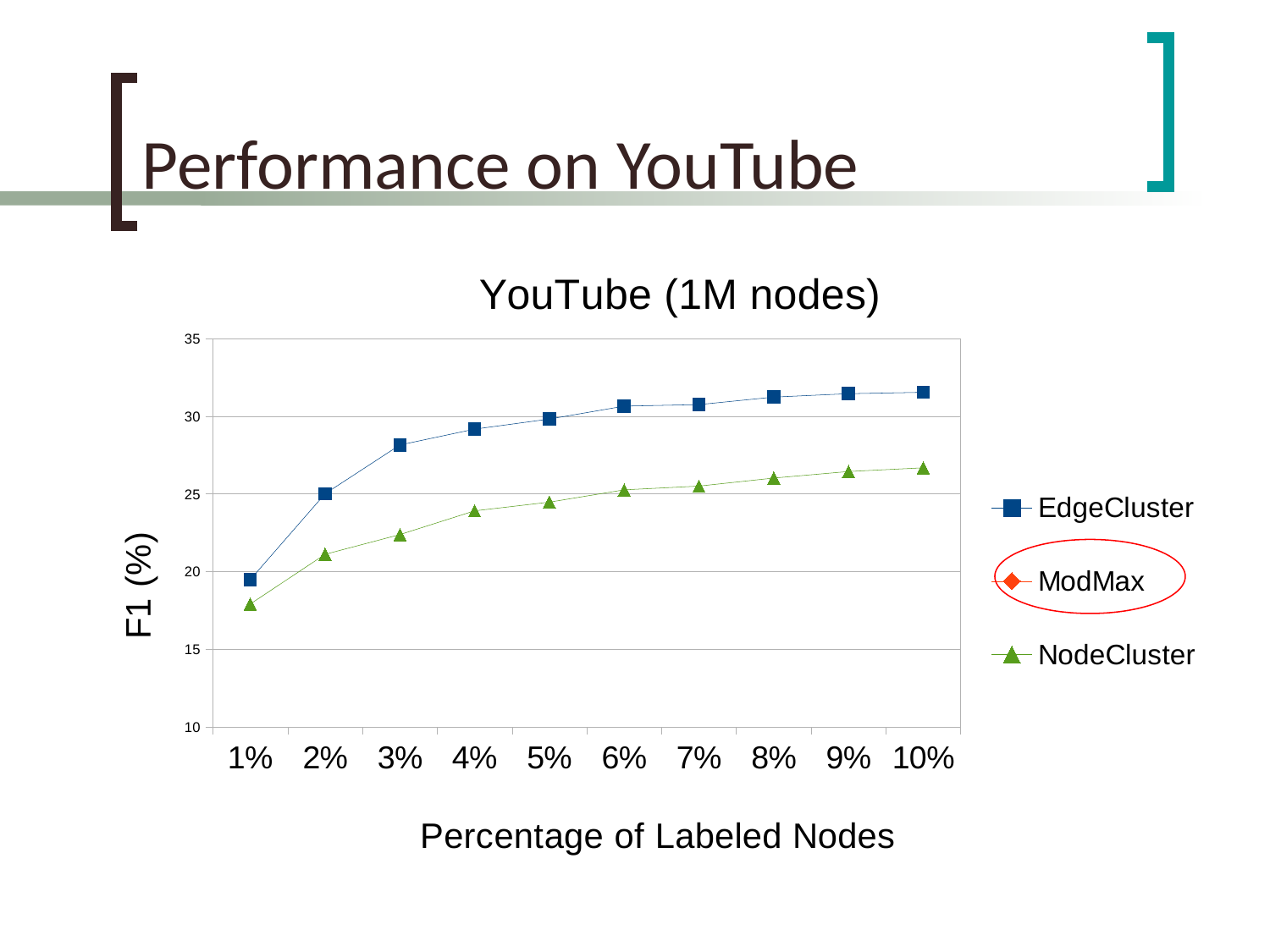
What kind of chart is shown on the slide? line chart Is the F1 value for EdgeCluster at 10% labeled nodes greater or less than 30? greater At which percentage of labeled nodes is the EdgeCluster F1 value highest? 10% Does the F1 value for EdgeCluster rise or fall as the percentage of labeled nodes increases? rise At 5% labeled nodes, which series has the higher F1 value, EdgeCluster or NodeCluster? EdgeCluster What is the title of the chart? YouTube (1M nodes) How many percentage-of-labeled-nodes points are shown on the x axis? 10 At which percentage of labeled nodes is the NodeCluster F1 value lowest? 1% Is the F1 value for NodeCluster at 10% labeled nodes greater or less than 25? greater How many series does the legend list? 3 Which legend entry is circled in red? ModMax Is the F1 value for NodeCluster at 1% labeled nodes greater or less than 20? less